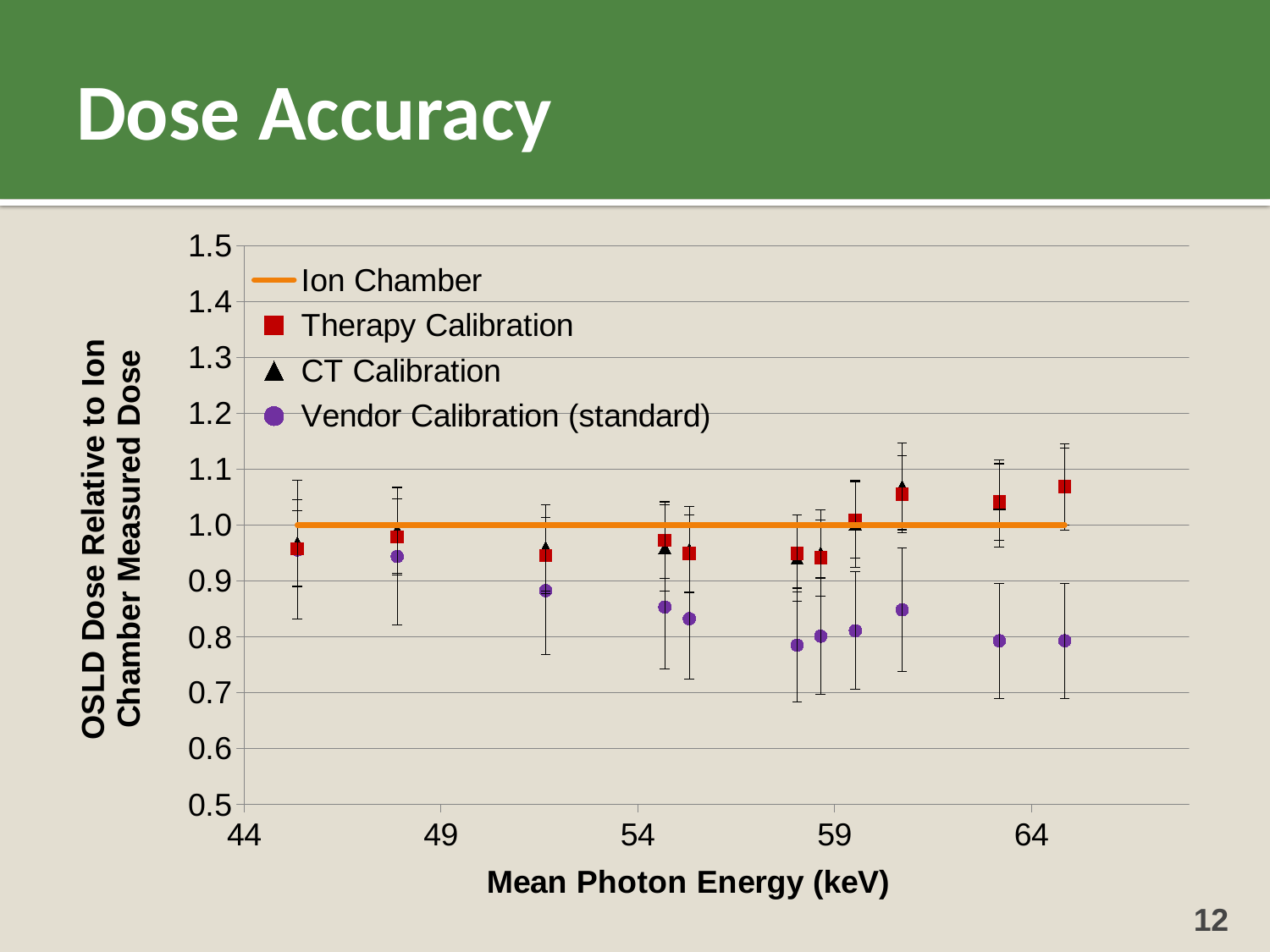
Are the Vendor Calibration (standard) values greater or less than 1.0? less Is the Therapy Calibration value at about 45 keV greater or less than 1.0? less How many series does the legend list? 4 At what value does the Ion Chamber line sit on the y axis? 1.0 Do the Vendor Calibration (standard) values generally rise or fall as mean photon energy increases? fall What kind of chart is shown on the slide? Scatter chart Is the Vendor Calibration (standard) value at about 64 keV greater or less than 0.9? less Do the Therapy Calibration values generally rise or fall as mean photon energy increases? rise At about 64 keV, which is larger: the Therapy Calibration value or the Vendor Calibration (standard) value? Therapy Calibration What is the label of the x axis? Mean Photon Energy (keV)